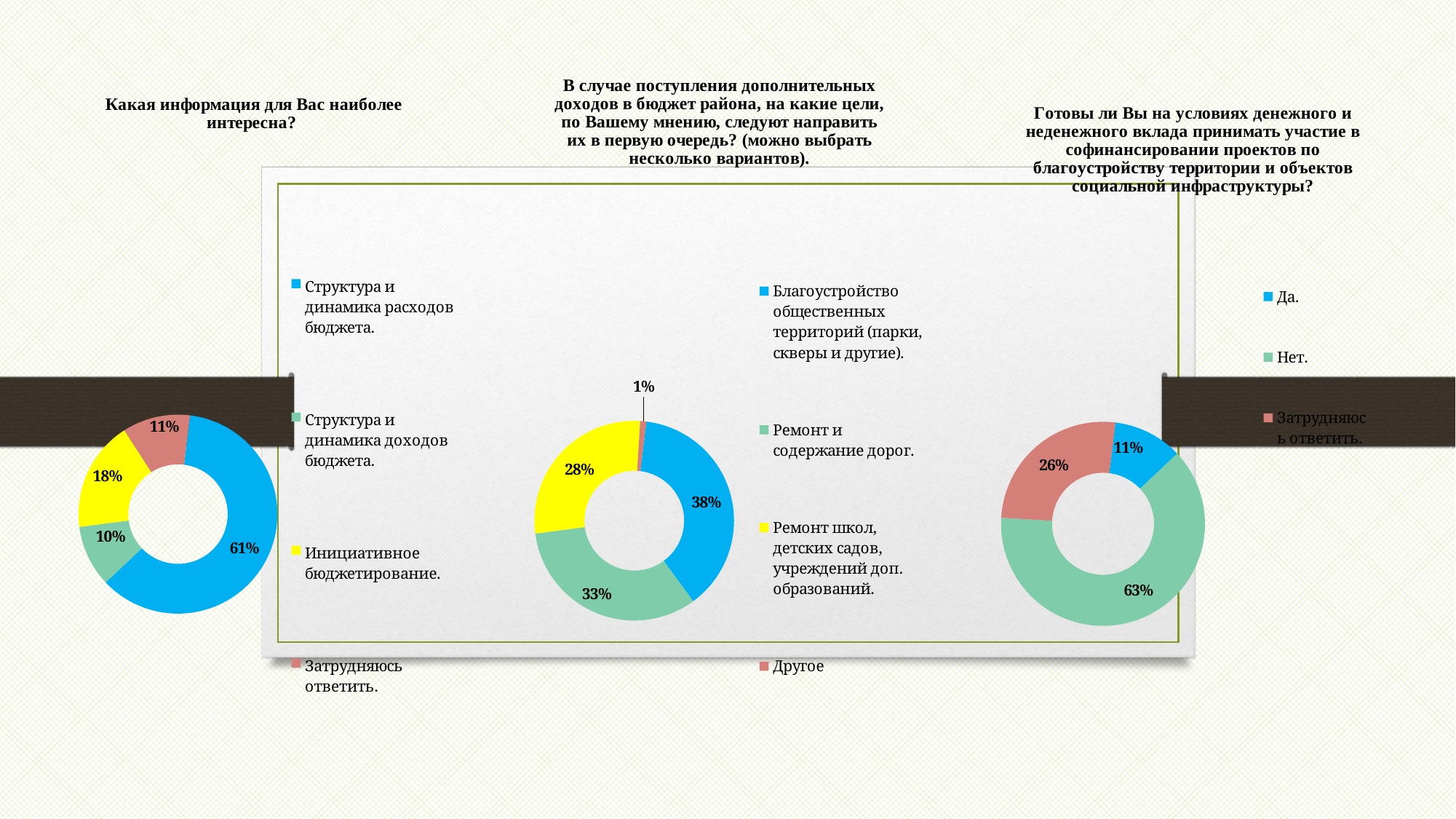
In the left chart ("Какая информация для Вас наиболее интересна?"), what share is labelled for "Структура и динамика расходов бюджета"? 61% In the right chart (about co-financing participation), what share answered "Нет."? 63% In the right chart (about co-financing participation), how many categories does the legend list? 3 What type of chart is used for all three charts on the slide? Doughnut (pie) chart In the left chart ("Какая информация для Вас наиболее интересна?"), how many categories does the legend list? 4 In the middle chart (about additional budget revenues), which category has the largest share? Благоустройство общественных территорий (парки, скверы и другие) In the middle chart (about additional budget revenues), what is the difference in percentage points between "Благоустройство общественных территорий" and "Ремонт школ, детских садов, учреждений доп. образований"? 10 In the right chart (about co-financing participation), which is larger: "Да." or "Затрудняюсь ответить."? Затрудняюсь ответить. In the left chart ("Какая информация для Вас наиболее интересна?"), which category has the smallest share? Структура и динамика доходов бюджета In the middle chart (about additional budget revenues), what share is labelled for "Другое"? 1% In the left chart ("Какая информация для Вас наиболее интересна?"), what share is labelled for "Инициативное бюджетирование"? 18% In the middle chart (about additional budget revenues), what share is labelled for "Ремонт и содержание дорог"? 33%